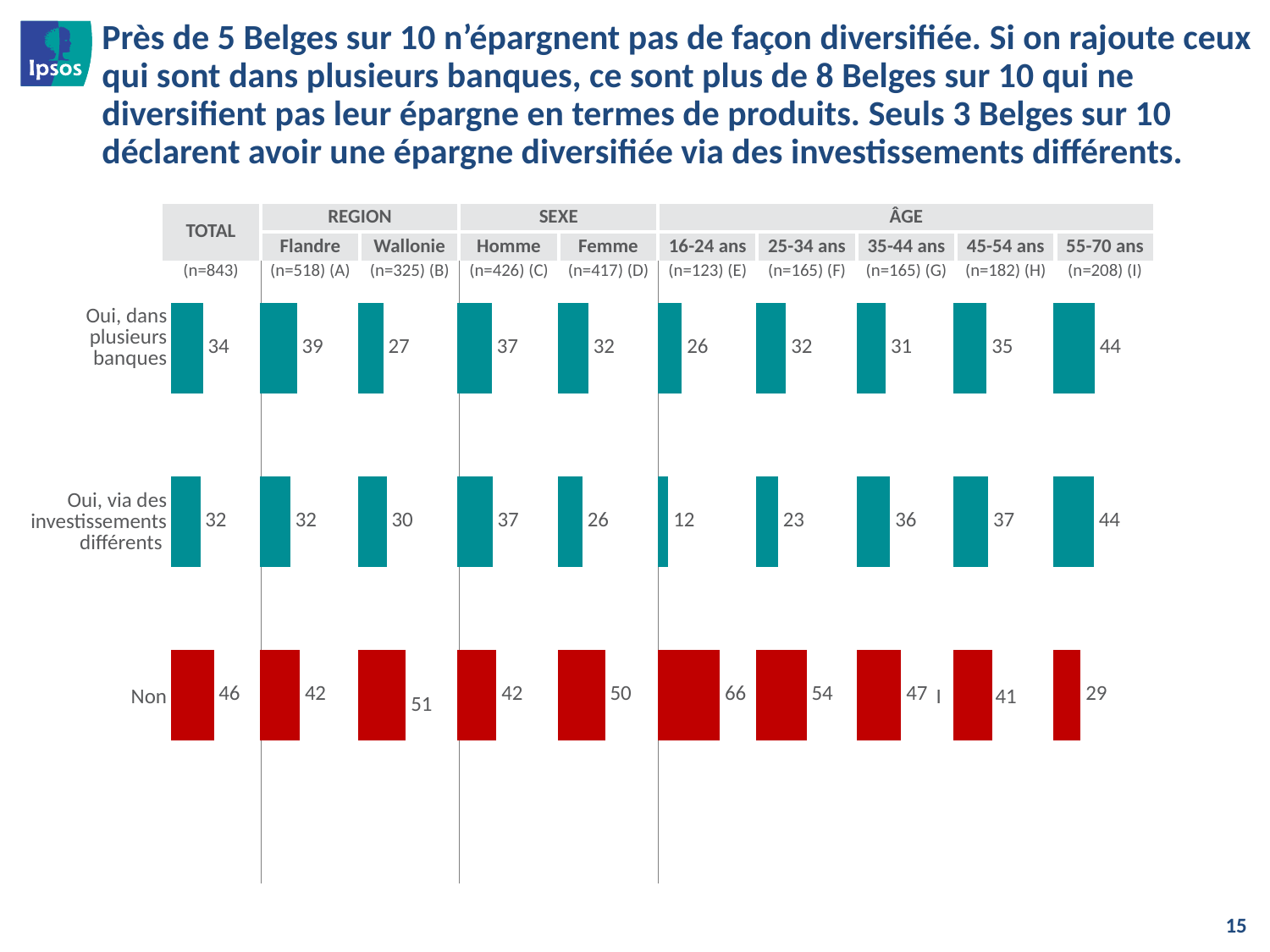
What is the difference between the "Non" values for Femme and Homme? 8 Across the age-group columns, which age group has the highest value for "Non"? 16-24 ans In the 16-24 ans column, what is the value for "Oui, via des investissements différents"? 12 Across the age-group columns, which age group has the lowest value for "Oui, via des investissements différents"? 16-24 ans What is the difference between the "Non" values for Wallonie and Flandre? 9 What colour are the bars for the "Non" row? Red In the Flandre column, what is the value for "Oui, dans plusieurs banques"? 39 In the 55-70 ans column, what is the value for "Non"? 29 Which is larger: the "Oui, dans plusieurs banques" value for Homme or for Femme? Homme How many response categories (rows) are plotted in the chart? 3 In the TOTAL column, what is the value for "Non"? 46 What kind of chart is used on this slide? Bar chart